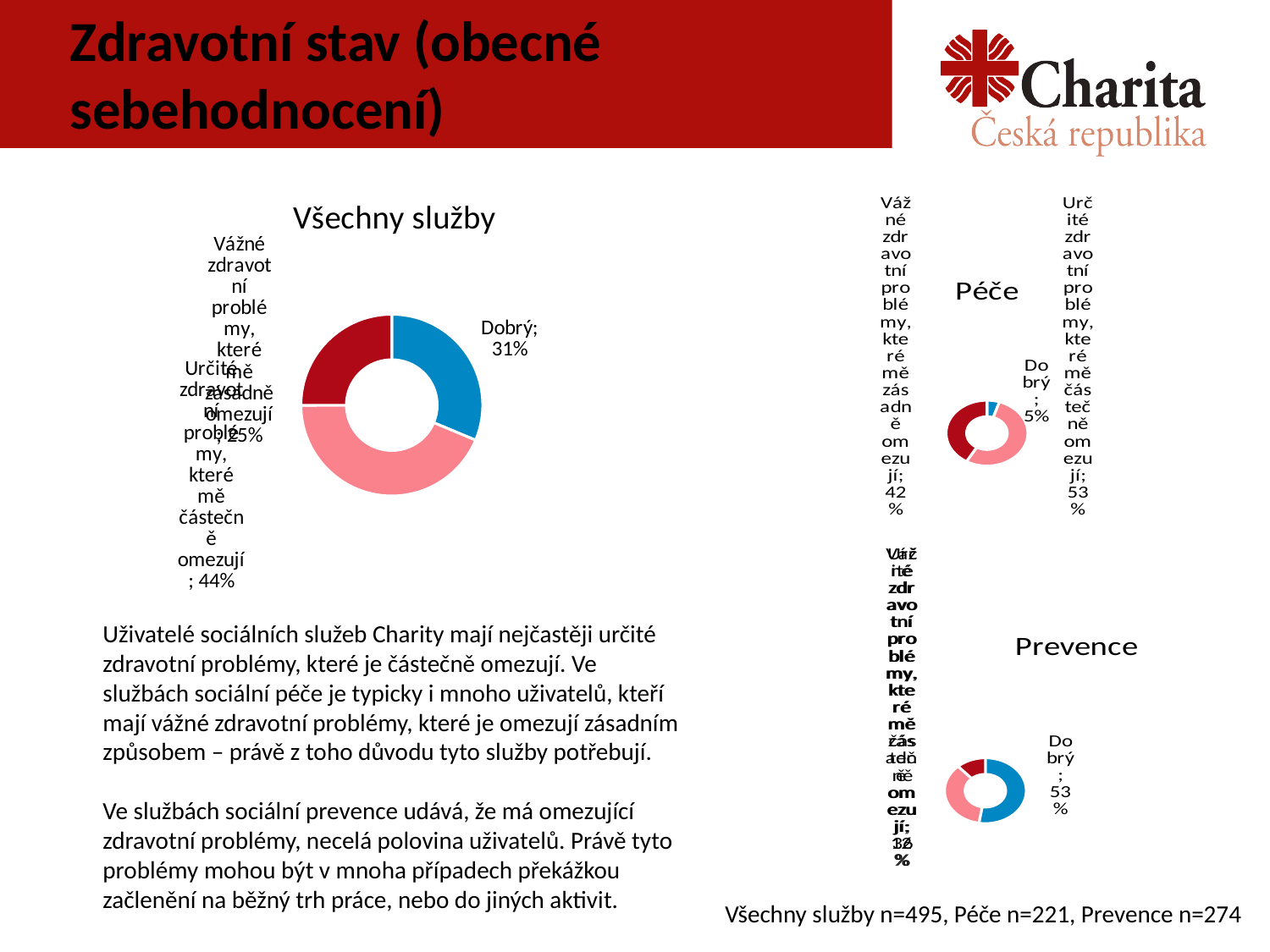
In the 'Všechny služby' chart, what share is labelled 'Určité zdravotní problémy, které mě částečně omezují'? 44% In the 'Péče' chart, what share is labelled 'Dobrý'? 5% In the 'Všechny služby' chart, what share is labelled 'Vážné zdravotní problémy, které mě zásadně omezují'? 25% In the 'Péče' chart, which is larger: the 'Dobrý' share or the 'Vážné zdravotní problémy' share? Vážné zdravotní problémy In the 'Všechny služby' chart, which category has the smallest share? Vážné zdravotní problémy, které mě zásadně omezují In the 'Všechny služby' chart, which category has the largest share? Určité zdravotní problémy, které mě částečně omezují In the 'Péče' chart, what share is labelled 'Vážné zdravotní problémy, které mě zásadně omezují'? 42% In the 'Všechny služby' chart, what is the difference between the 'Určité zdravotní problémy' share and the 'Dobrý' share? 13% In the 'Prevence' chart, what share is labelled 'Dobrý'? 53% What kind of chart is the 'Všechny služby' chart? Doughnut chart In the 'Péče' chart, what share is labelled 'Určité zdravotní problémy, které mě částečně omezují'? 53% In the 'Všechny služby' chart, what share is labelled 'Dobrý'? 31%